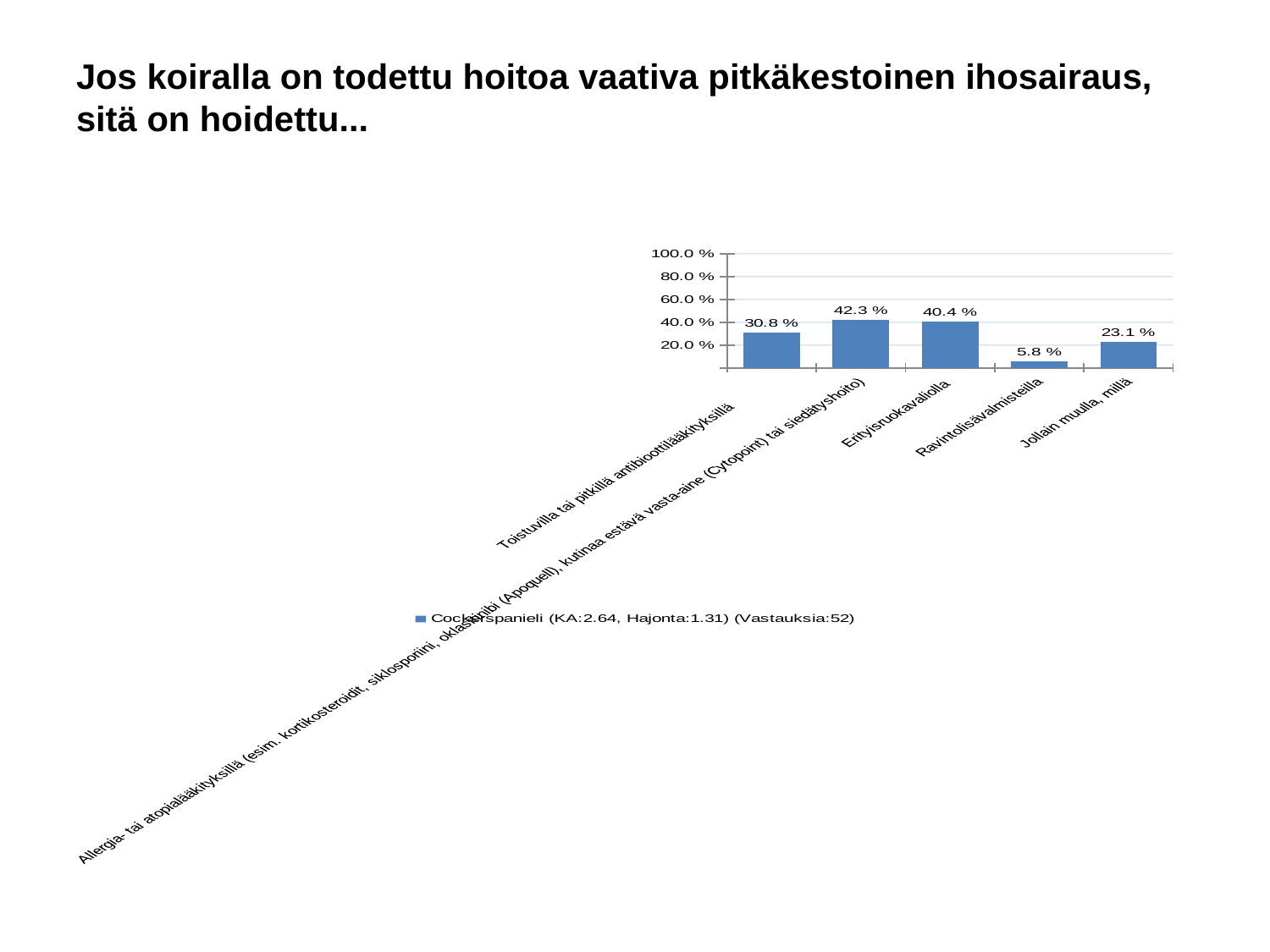
How many bars (categories) does the chart show? 5 What is the value for "Jollain muulla, millä"? 23.1 % Which category has the lowest value? Ravintolisävalmisteilla Which category has the highest value? Allergia- tai atopialääkityksillä (esim. kortikosteroidit, siklosporiini, oklasitinibi (Apoquell), kutinaa estävä vasta-aine (Cytopoint) tai siedätyshoito) What is the value for "Toistuvilla tai pitkillä antibioottilääkityksillä"? 30.8 % What is the difference between the values for "Erityisruokavaliolla" and "Jollain muulla, millä"? 17.3 % How many series does the legend list? 1 What is the value for "Ravintolisävalmisteilla"? 5.8 % Which is larger, the value for "Toistuvilla tai pitkillä antibioottilääkityksillä" or the value for "Jollain muulla, millä"? Toistuvilla tai pitkillä antibioottilääkityksillä How many responses (Vastauksia) does the legend entry report? 52 What kind of chart is shown on the slide? bar chart What is the value for "Erityisruokavaliolla"? 40.4 %